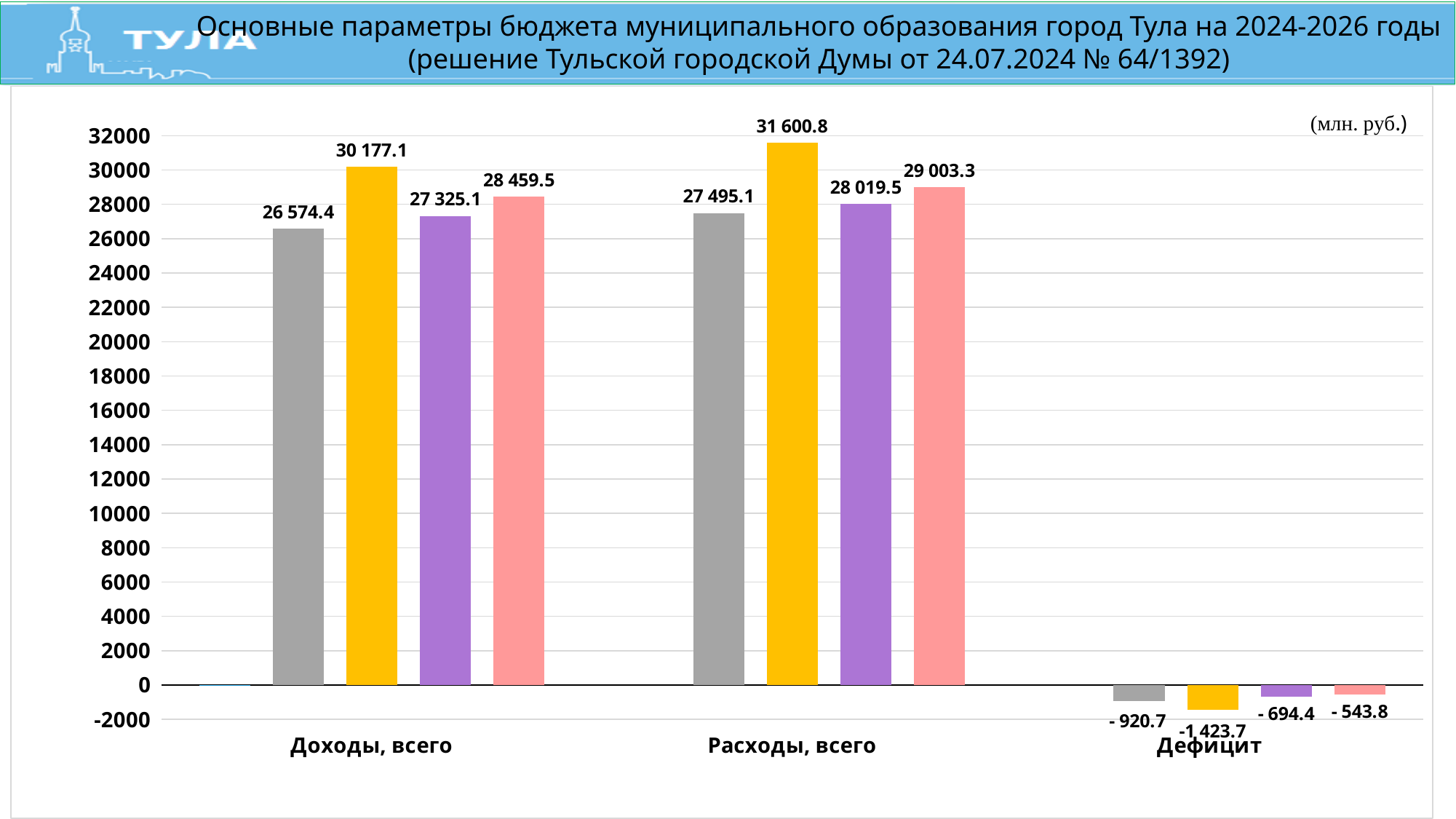
What is the value of the yellow bar in the "Доходы, всего" group? 30 177.1 Which is larger: the purple bar or the pink bar in the "Доходы, всего" group? the pink bar What is the difference between the yellow bar in "Расходы, всего" and the yellow bar in "Доходы, всего"? 1 423.7 What is the value of the grey bar in the "Расходы, всего" group? 27 495.1 Which bar in the "Расходы, всего" group has the highest value? the yellow bar (31 600.8) What unit is indicated in the top right corner of the chart? млн. руб. How many categories are shown along the x axis? 3 Which bar in the "Доходы, всего" group has the lowest value? the grey bar (26 574.4) What kind of chart is shown on the slide? bar chart What is the value of the purple bar in the "Доходы, всего" group? 27 325.1 What is the value of the pink bar in the "Дефицит" group? - 543.8 Is the value of the grey bar in the "Доходы, всего" group greater or less than 26000? greater